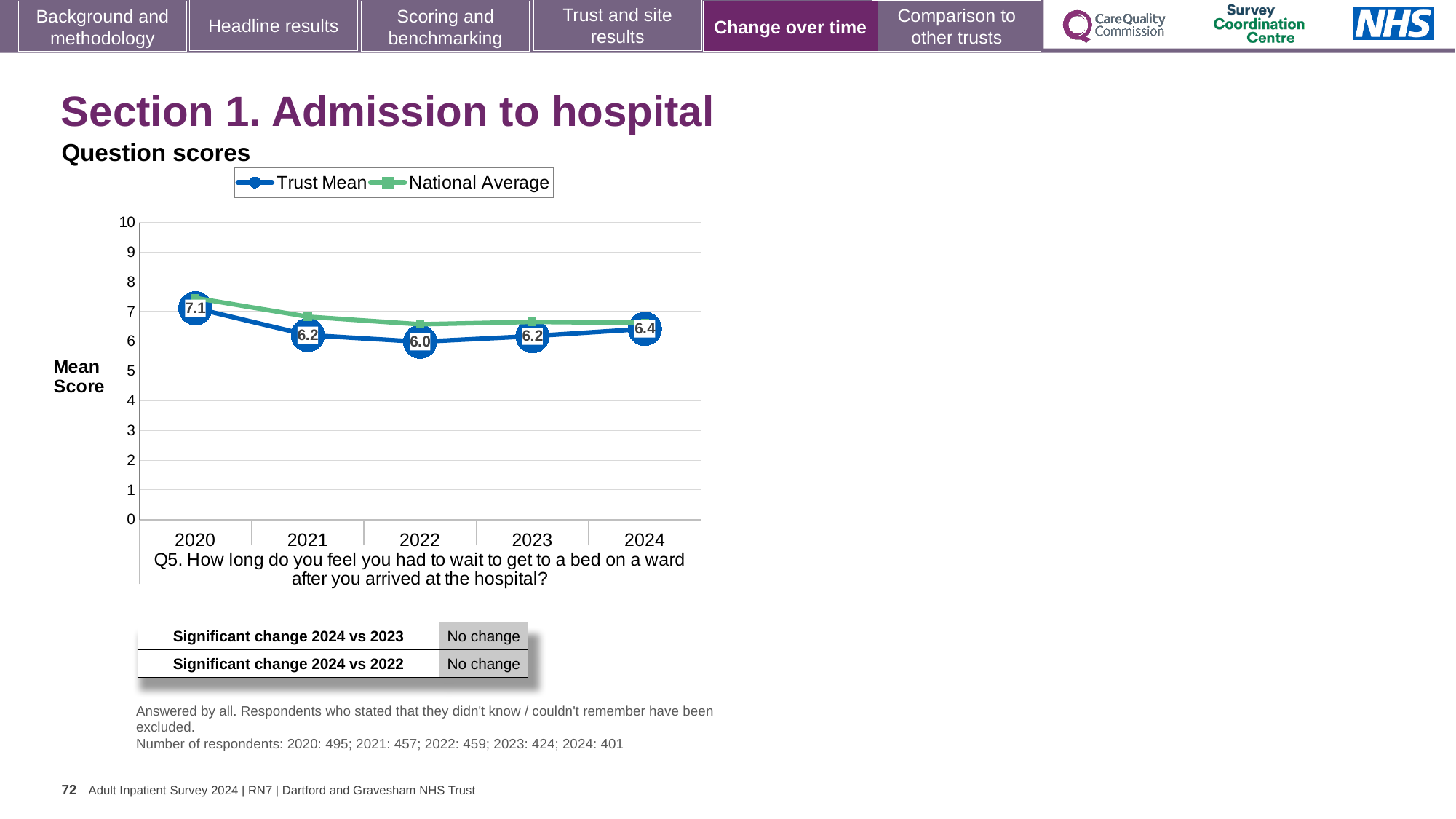
Is the National Average value for 2022 greater or less than 7? less Is the National Average value for 2020 greater or less than 7? greater What is the difference between the Trust Mean score in 2020 and in 2024? 0.7 What is the Trust Mean score for 2022? 6.0 What is the Trust Mean score for 2020? 7.1 In which year is the Trust Mean score lowest? 2022 What is the Trust Mean score for 2024? 6.4 How many series does the chart legend list? 2 Which is larger, the Trust Mean score in 2020 or in 2022? 2020 How many years are plotted on the x axis of the chart? 5 In which year is the Trust Mean score highest? 2020 What kind of chart is shown on the slide? Line chart